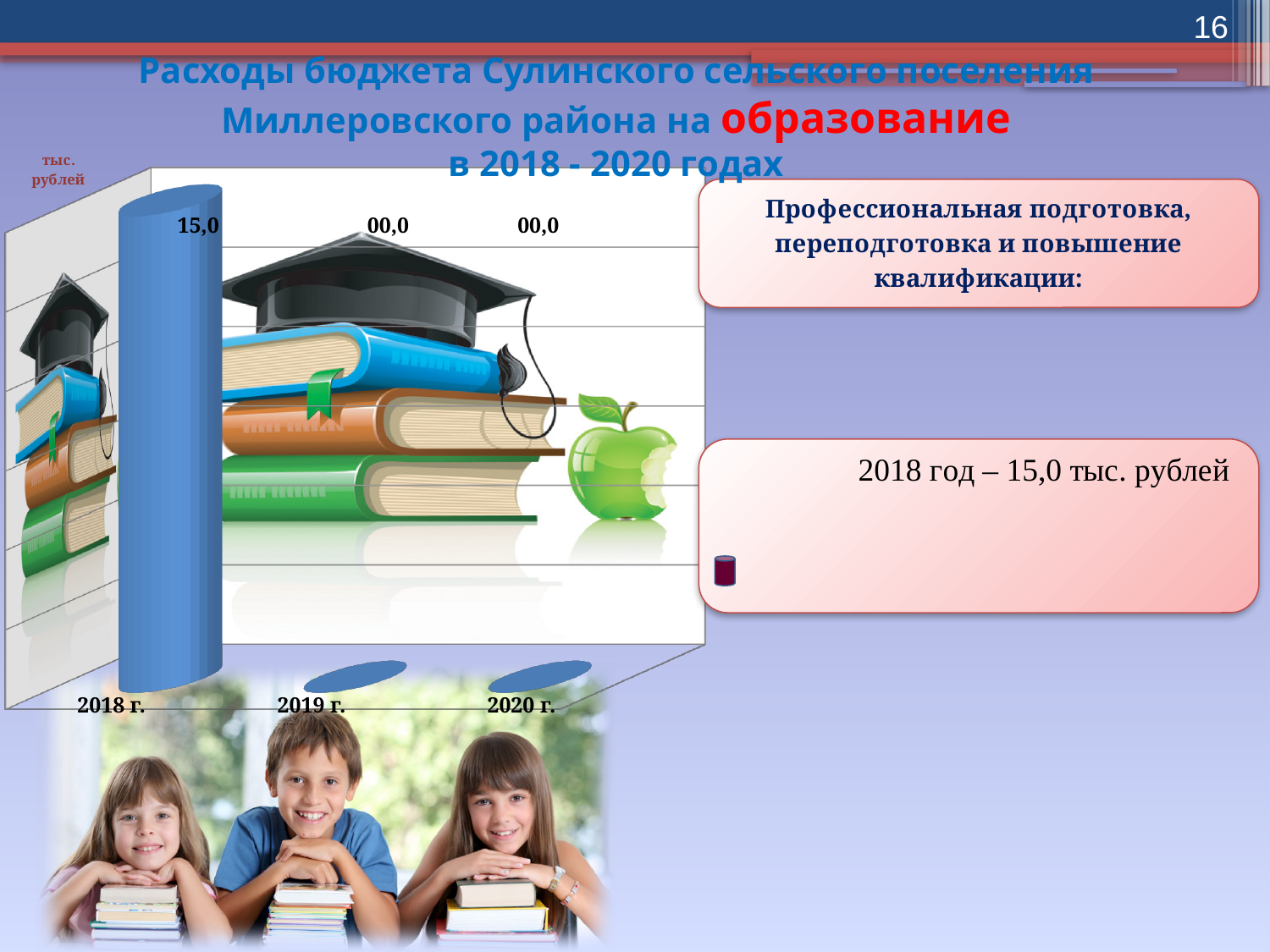
What is the value for 2019 г. in the chart? 00,0 What unit of measurement is indicated for the chart values? тыс. рублей What is the value for 2018 г. in the chart? 15,0 What colour are the bars in the chart? blue What is the difference between the values for 2018 г. and 2019 г.? 15,0 What is the value for 2020 г. in the chart? 00,0 How many years (categories) are shown on the x axis of the chart? 3 What kind of chart is shown on the slide? bar chart Do the values rise or fall from 2018 г. to 2020 г.? fall Which is larger, the value for 2018 г. or the value for 2020 г.? 2018 г. Which year has the highest value in the chart? 2018 г. What is the total of the values for 2018 г., 2019 г. and 2020 г.? 15,0